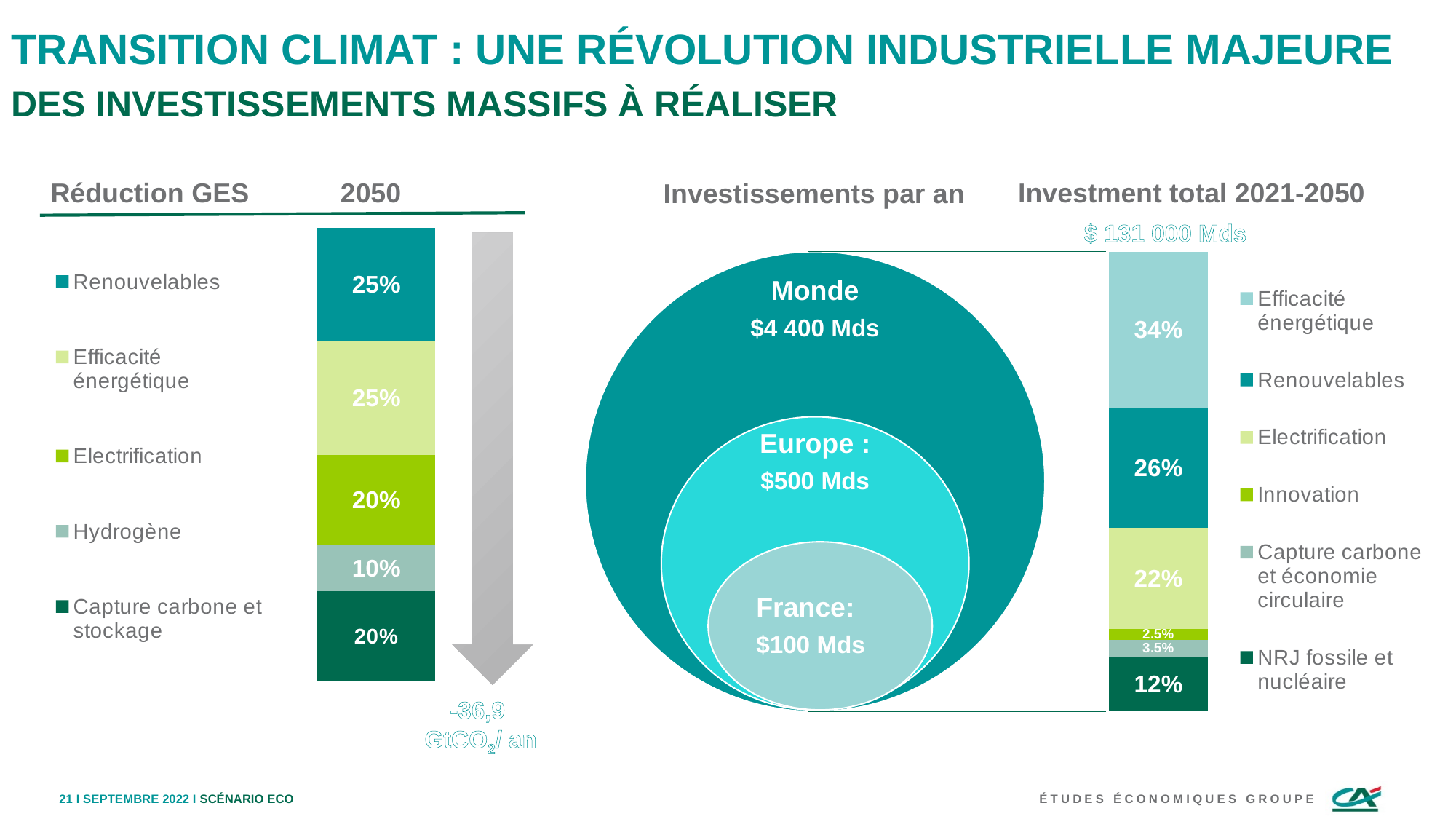
In the 'Réduction GES 2050' chart, what is the difference between the Renouvelables share and the Hydrogène share? 15% In the 'Réduction GES 2050' chart, how many categories does the legend list? 5 What type of chart is the 'Investment total 2021-2050' chart? Stacked bar chart In the 'Investment total 2021-2050' chart, what is the difference between the Efficacité énergétique share and the NRJ fossile et nucléaire share? 22% In the 'Investment total 2021-2050' chart, which category has the largest share? Efficacité énergétique In the 'Investment total 2021-2050' chart, which is larger: the share for Renouvelables or the share for Electrification? Renouvelables In the 'Réduction GES 2050' chart, what share is shown for Hydrogène? 10% In the 'Investment total 2021-2050' chart, what share is shown for Innovation? 2.5% In the 'Investment total 2021-2050' chart, which category has the smallest share? Innovation In the 'Réduction GES 2050' chart, which category has the smallest share? Hydrogène In the 'Réduction GES 2050' chart, what share is shown for Electrification? 20% In the 'Investment total 2021-2050' chart, what share is shown for Efficacité énergétique? 34%